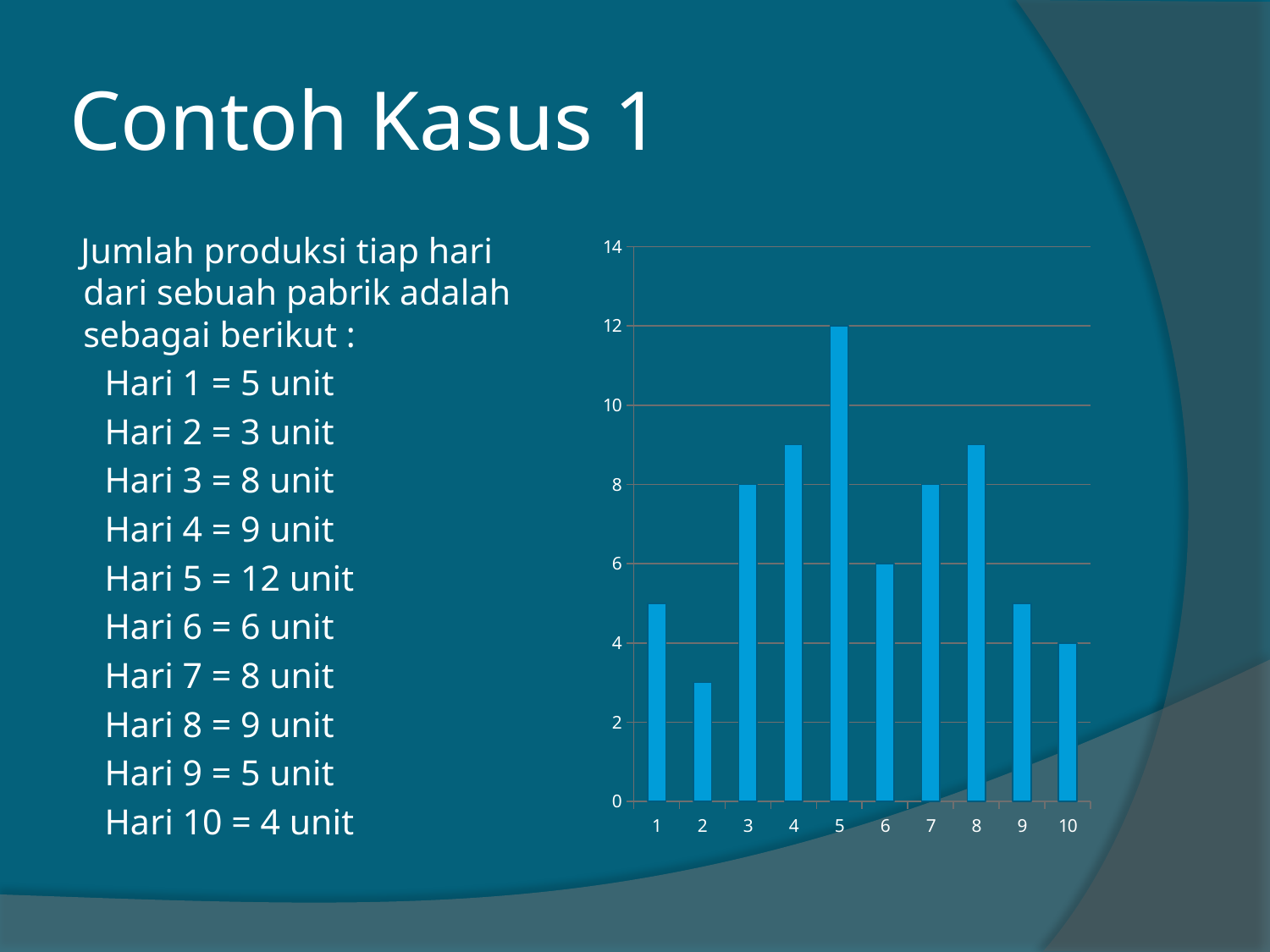
Which day has the larger value, day 3 or day 2? 3 How many categories (days) are plotted on the x axis of the chart? 10 Which day has the lowest bar in the chart? 2 What is the value of the bar for day 5? 12 Do the bar values rise or fall from day 8 to day 10? fall Is the value for day 9 greater or less than 6? less What is the value of the bar for day 10? 4 Is the value for day 4 greater or less than 8? greater What is the difference between the values for day 5 and day 6? 6 What is the value of the bar for day 6? 6 What kind of chart is shown on the slide? bar chart Which day has the highest bar in the chart? 5